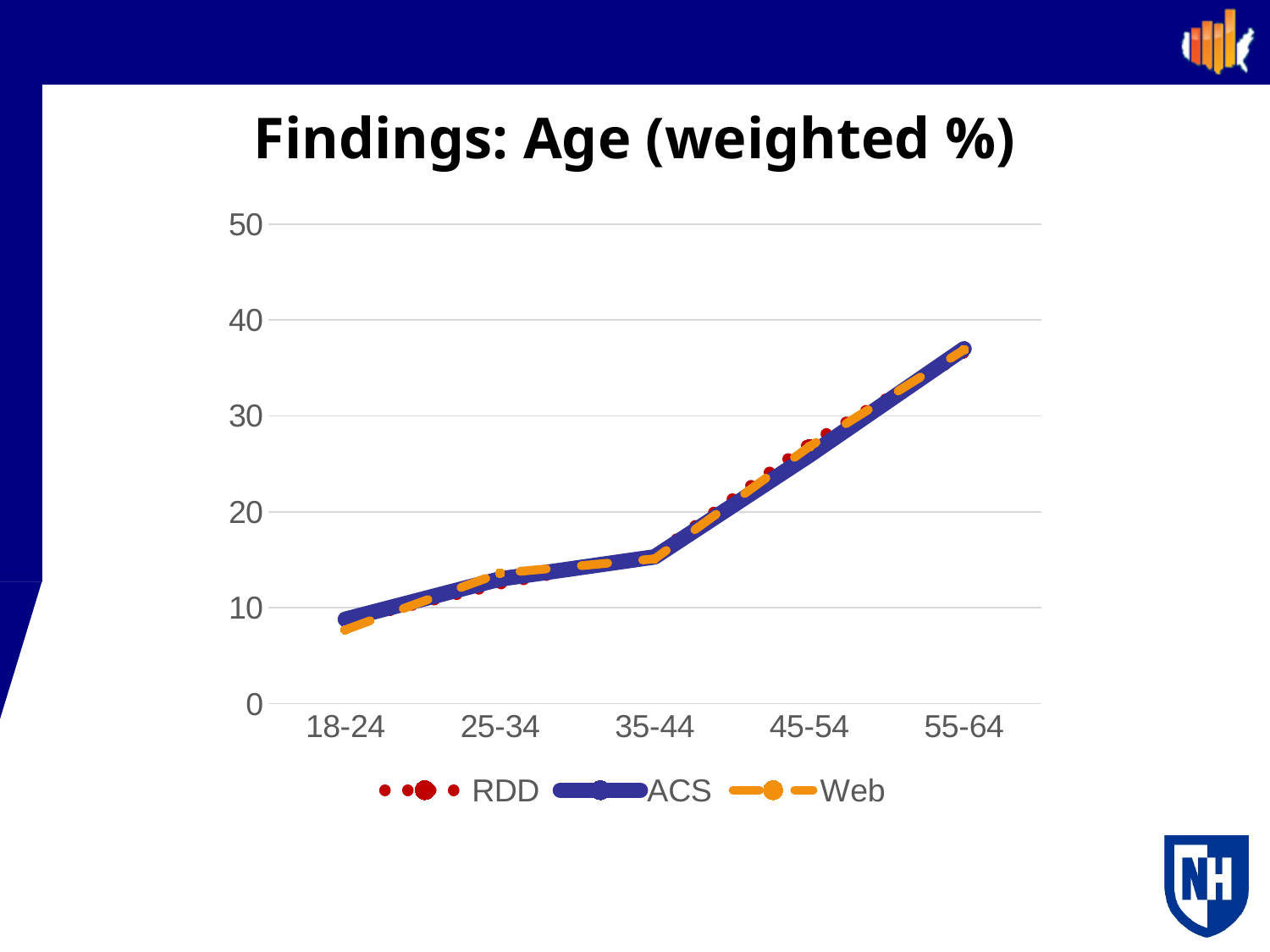
Which age category has the lowest value for the ACS series? 18-24 What kind of chart is shown on the slide? line chart Which is larger for the ACS series: the value at 35-44 or the value at 55-64? 55-64 How many series does the legend list? 3 Is the value for the Web series at 18-24 greater or less than 10? less Is the value for the ACS series at 55-64 greater or less than 30? greater What is the title of the chart? Findings: Age (weighted %) Which age category has the highest value for the Web series? 55-64 Do the values for the ACS series rise or fall from 18-24 to 55-64? rise Is the value for the ACS series at 45-54 greater or less than 20? greater What are the names of the series listed in the legend? RDD, ACS, Web How many age categories are shown on the x axis? 5